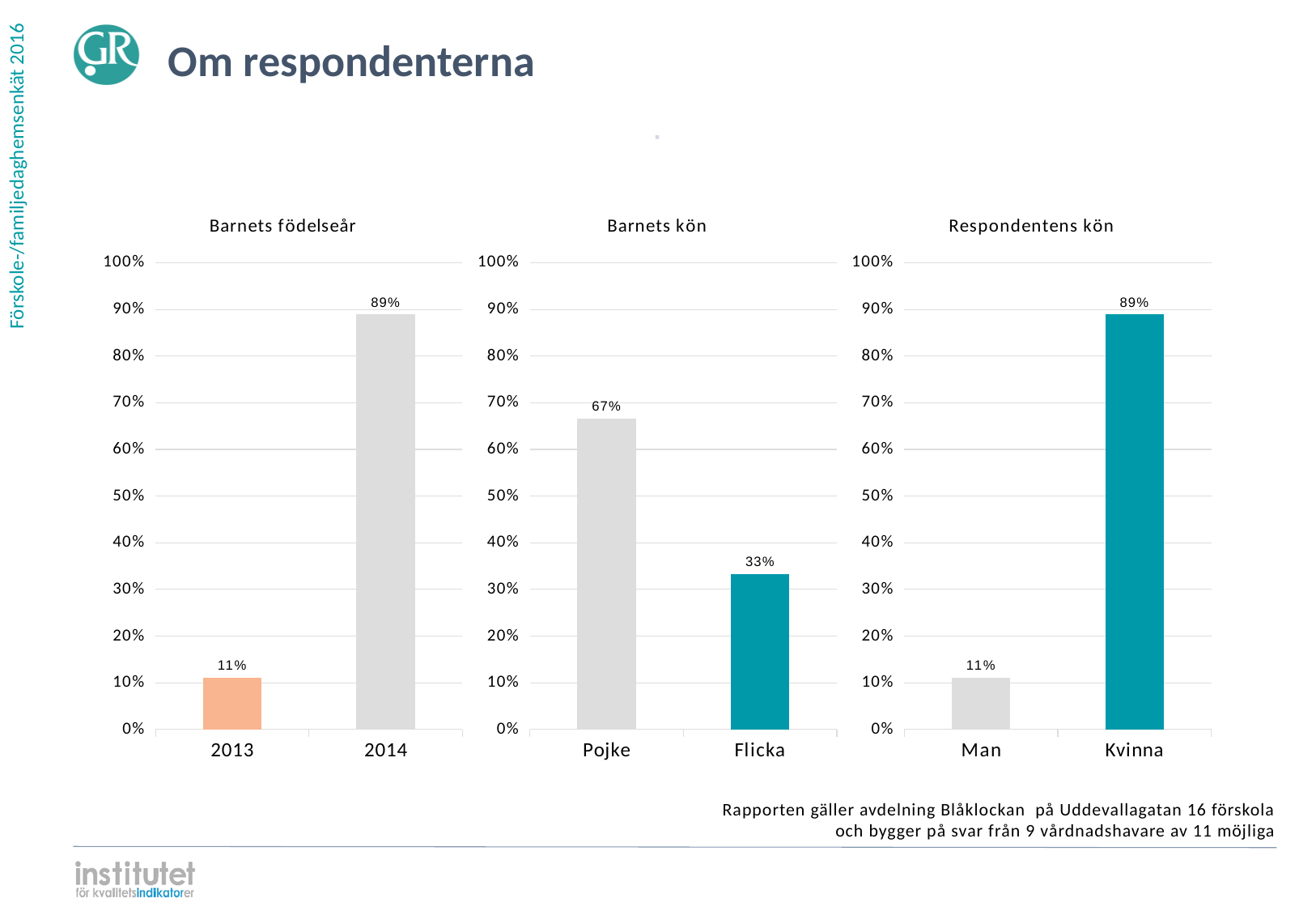
In the 'Barnets födelseår' chart, which is larger, the value for 2013 or the value for 2014? 2014 In the 'Respondentens kön' chart, which category has the lowest value? Man In the 'Barnets födelseår' chart, what is the value for 2013? 11% In the 'Barnets kön' chart, what is the difference between the values for Pojke and Flicka? 34% In the 'Barnets födelseår' chart, what is the value for 2014? 89% In the 'Respondentens kön' chart, what is the value for Kvinna? 89% What kind of chart is the 'Respondentens kön' chart? Bar chart How many categories are shown in the 'Barnets kön' chart? 2 In the 'Respondentens kön' chart, what is the difference between the values for Kvinna and Man? 78% In the 'Barnets kön' chart, which category has the highest value? Pojke In the 'Barnets kön' chart, what is the value for Pojke? 67% In the 'Barnets kön' chart, what is the value for Flicka? 33%